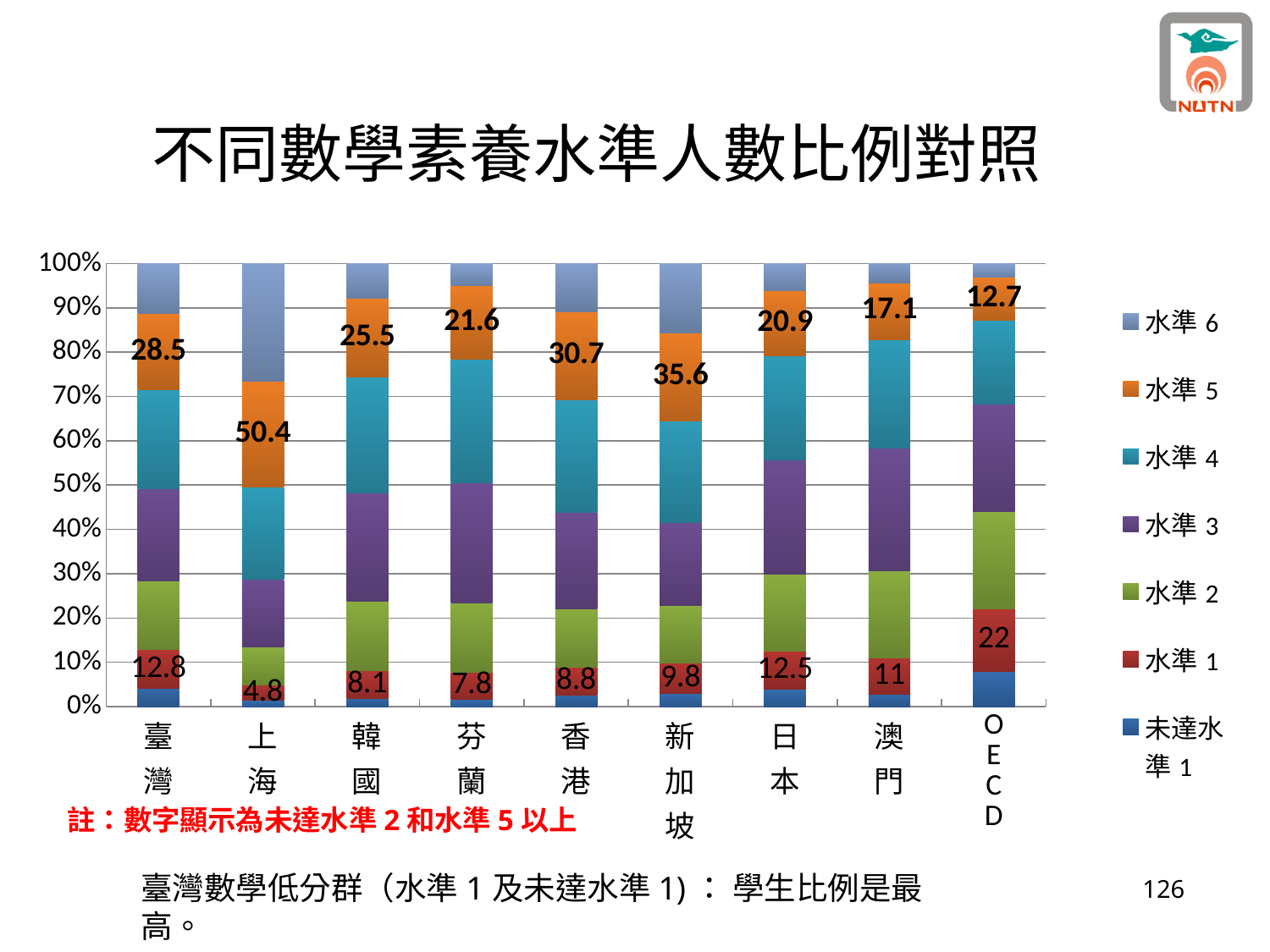
What is the 水準5以上 value labelled on the bar for 上海? 50.4 Which country/region has the lowest 未達水準2 value labelled on its bar? 上海 What is the 未達水準2 value labelled on the bar for OECD? 22 What is the difference between the 水準5以上 values labelled for 臺灣 and 日本? 7.6 Which country/region has the highest 水準5以上 value labelled on its bar? 上海 What is the 未達水準2 value labelled on the bar for 芬蘭? 7.8 What is the difference between the 未達水準2 values labelled for OECD and 臺灣? 9.2 Which has the larger 水準5以上 value labelled on its bar, 香港 or 新加坡? 新加坡 What kind of chart is shown on the slide? stacked bar chart How many series does the chart legend list? 7 What is the title of the chart on the slide? 不同數學素養水準人數比例對照 How many countries/regions are shown on the x axis of the chart? 9